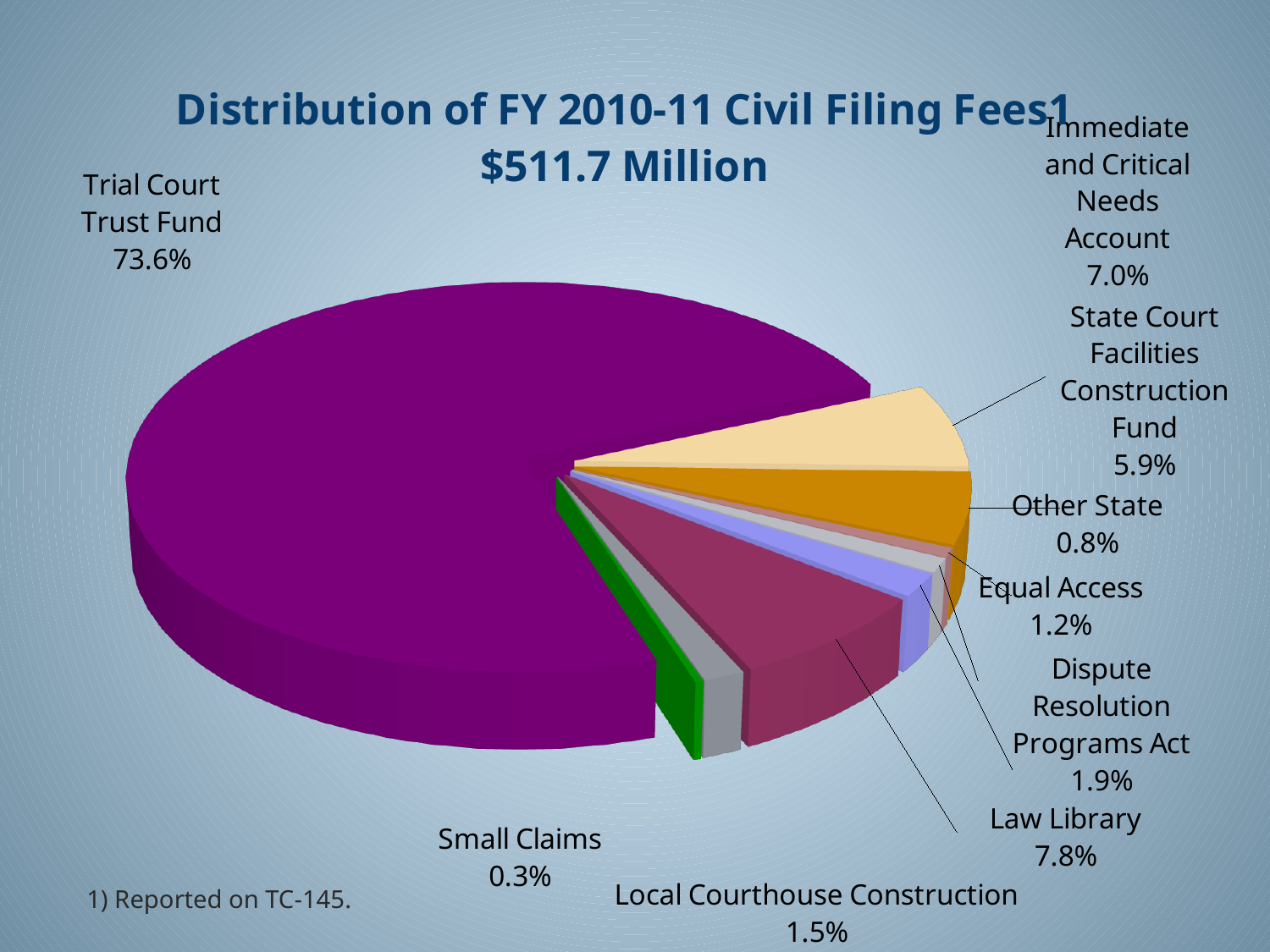
What share of civil filing fees goes to the Trial Court Trust Fund? 73.6% What kind of chart is shown on the slide? pie chart What percentage is shown for the State Court Facilities Construction Fund? 5.9% What percentage is shown for the Law Library slice? 7.8% What is the difference in percentage points between the Dispute Resolution Programs Act share and the Equal Access share? 0.7 What total dollar amount is given in the chart title? $511.7 Million Which category has the largest share of the pie? Trial Court Trust Fund What percentage is shown for Small Claims? 0.3% Which is larger, the share for Law Library or the share for the Immediate and Critical Needs Account? Law Library What percentage is shown for the Immediate and Critical Needs Account? 7.0% Which category has the smallest share of the pie? Small Claims How many slices does the pie chart have? 9